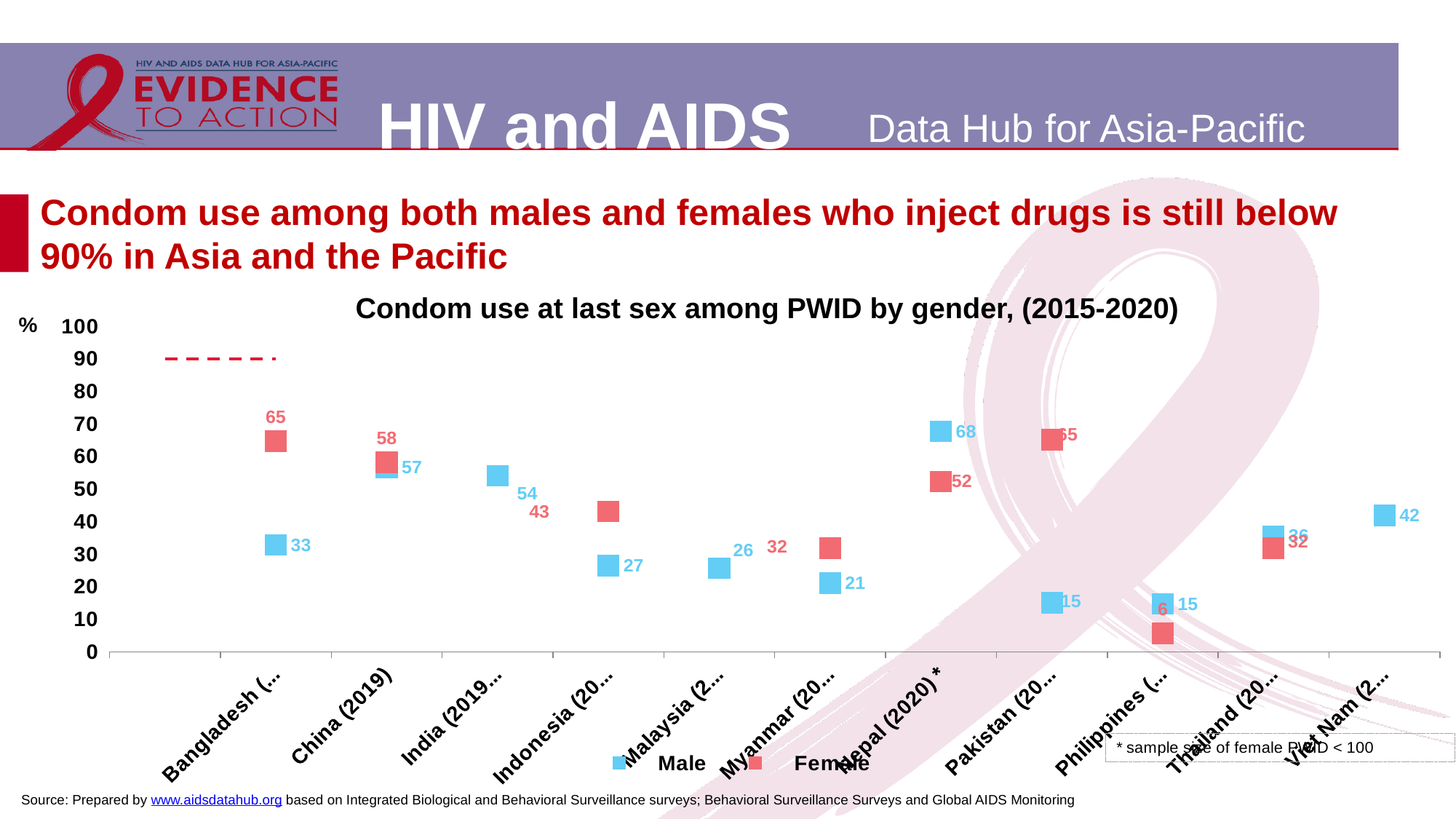
What is the Female value for Philippines? 6 For Nepal (2020), which is larger, the Male or the Female value? Male What is the difference between the Female and Male values for Pakistan? 50 Which country has the highest Male value? Nepal (2020) What is the Male value for Bangladesh? 33 What is the Male value for Nepal (2020)? 68 How many series does the legend list? 2 What is the difference between the Female and Male values for Bangladesh? 32 At what value on the y axis is the dashed red reference line drawn? 90 Which country has the lowest Female value? Philippines What is the Female value for Pakistan? 65 How many countries are shown on the x axis? 11